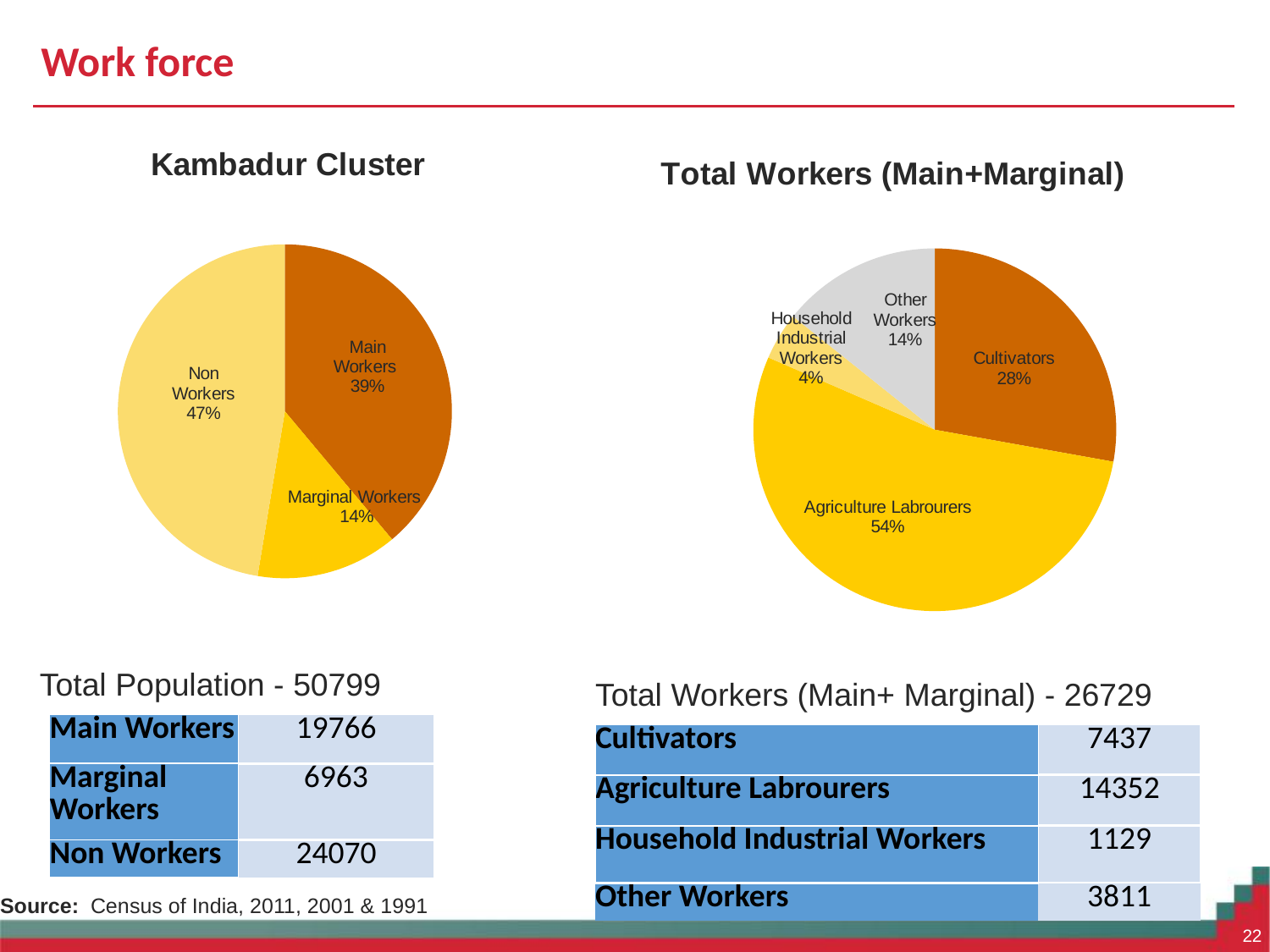
In the Total Workers (Main+Marginal) pie chart, which category has the largest slice? Agriculture Labrourers In the Kambadur Cluster pie chart, which category has the largest slice? Non Workers What type of chart is the Kambadur Cluster chart? Pie chart In the Kambadur Cluster pie chart, what share do Non Workers have? 47% In the Kambadur Cluster pie chart, how many slices are there? 3 In the Total Workers (Main+Marginal) pie chart, how many categories are shown? 4 In the Kambadur Cluster pie chart, which category has the smallest slice? Marginal Workers In the Kambadur Cluster pie chart, what is the difference in percentage points between Non Workers and Main Workers? 8 In the Total Workers (Main+Marginal) pie chart, which is larger, Cultivators or Other Workers? Cultivators In the Total Workers (Main+Marginal) pie chart, what share do Agriculture Labrourers have? 54% In the Kambadur Cluster pie chart, what share do Main Workers have? 39%